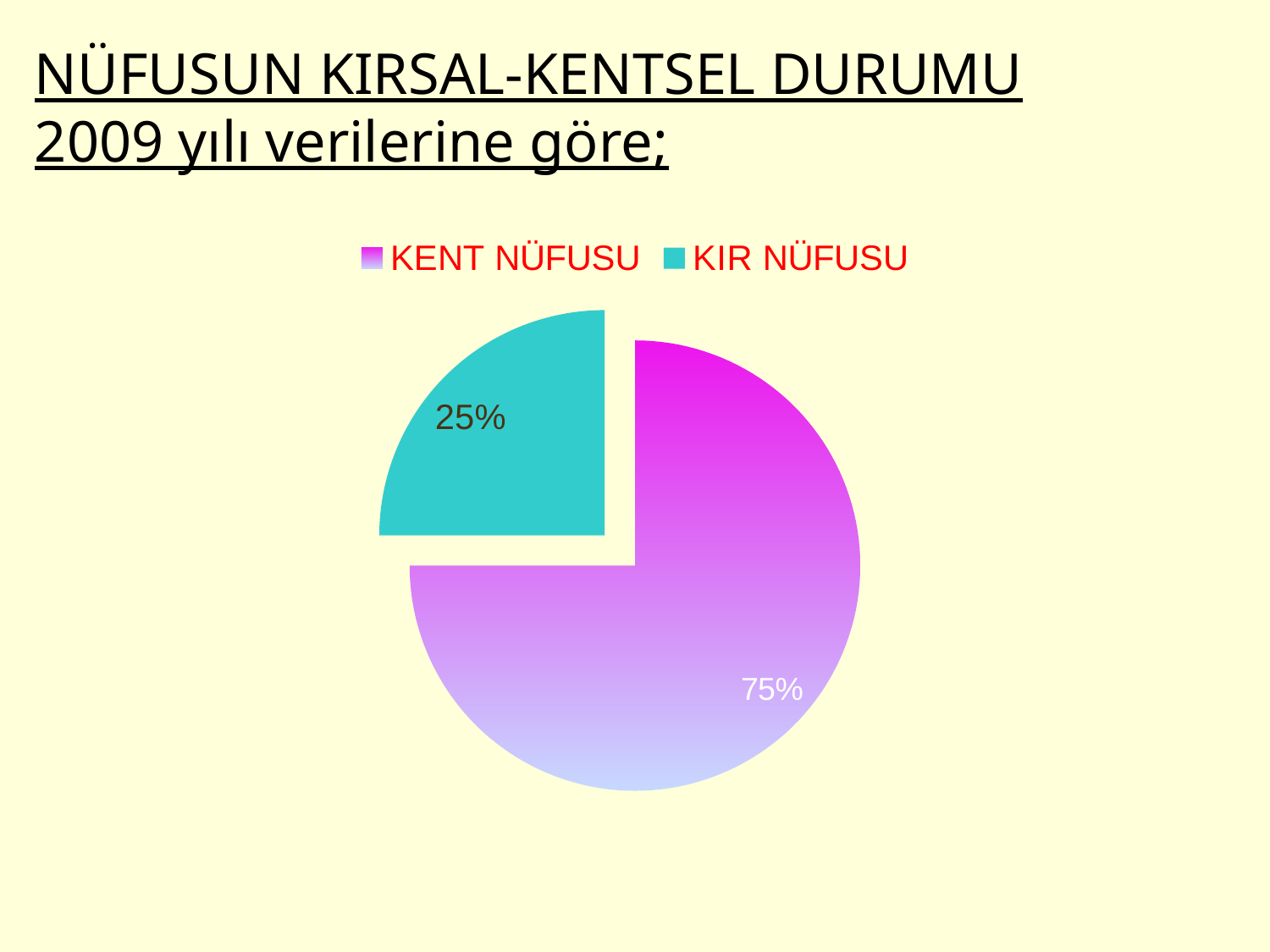
What share of the pie does KENT NÜFUSU represent? 75% Which slice is the largest in the pie chart? KENT NÜFUSU How many entries does the legend list? 2 What colour is the KIR NÜFUSU slice? Teal Which slice is the smallest in the pie chart? KIR NÜFUSU What share of the pie does KIR NÜFUSU represent? 25% Which slice is pulled out (exploded) from the pie? KIR NÜFUSU What is the difference in percentage points between KENT NÜFUSU and KIR NÜFUSU? 50 percentage points Which is larger, KENT NÜFUSU or KIR NÜFUSU? KENT NÜFUSU What kind of chart is shown on the slide? Pie chart How many slices does the pie chart have? 2 Is the value for KIR NÜFUSU greater or less than 50%? less